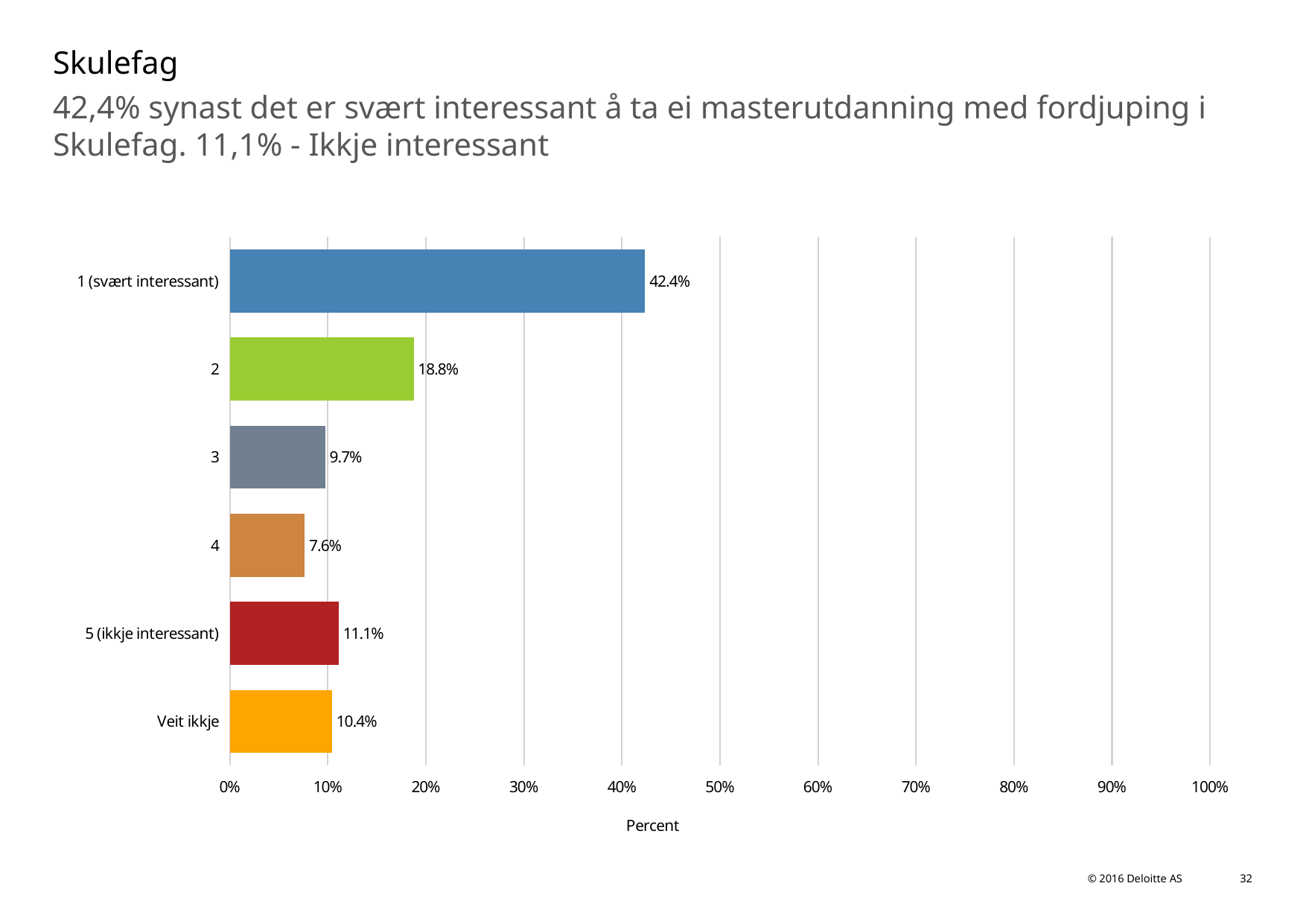
How many categories are shown in the chart? 6 Which is larger, the value for "3" or the value for "5 (ikkje interessant)"? 5 (ikkje interessant) What is the value for category "4"? 7.6% What is the label of the horizontal axis? Percent Is the value for "2" greater or less than 20%? less Which category has the lowest value? 4 What is the value for "Veit ikkje"? 10.4% What is the difference between the values for "5 (ikkje interessant)" and "Veit ikkje"? 0.7% What is the value for "1 (svært interessant)"? 42.4% What is the difference between the values for "1 (svært interessant)" and "2"? 23.6% What kind of chart is shown on the slide? bar chart Which category has the highest value? 1 (svært interessant)